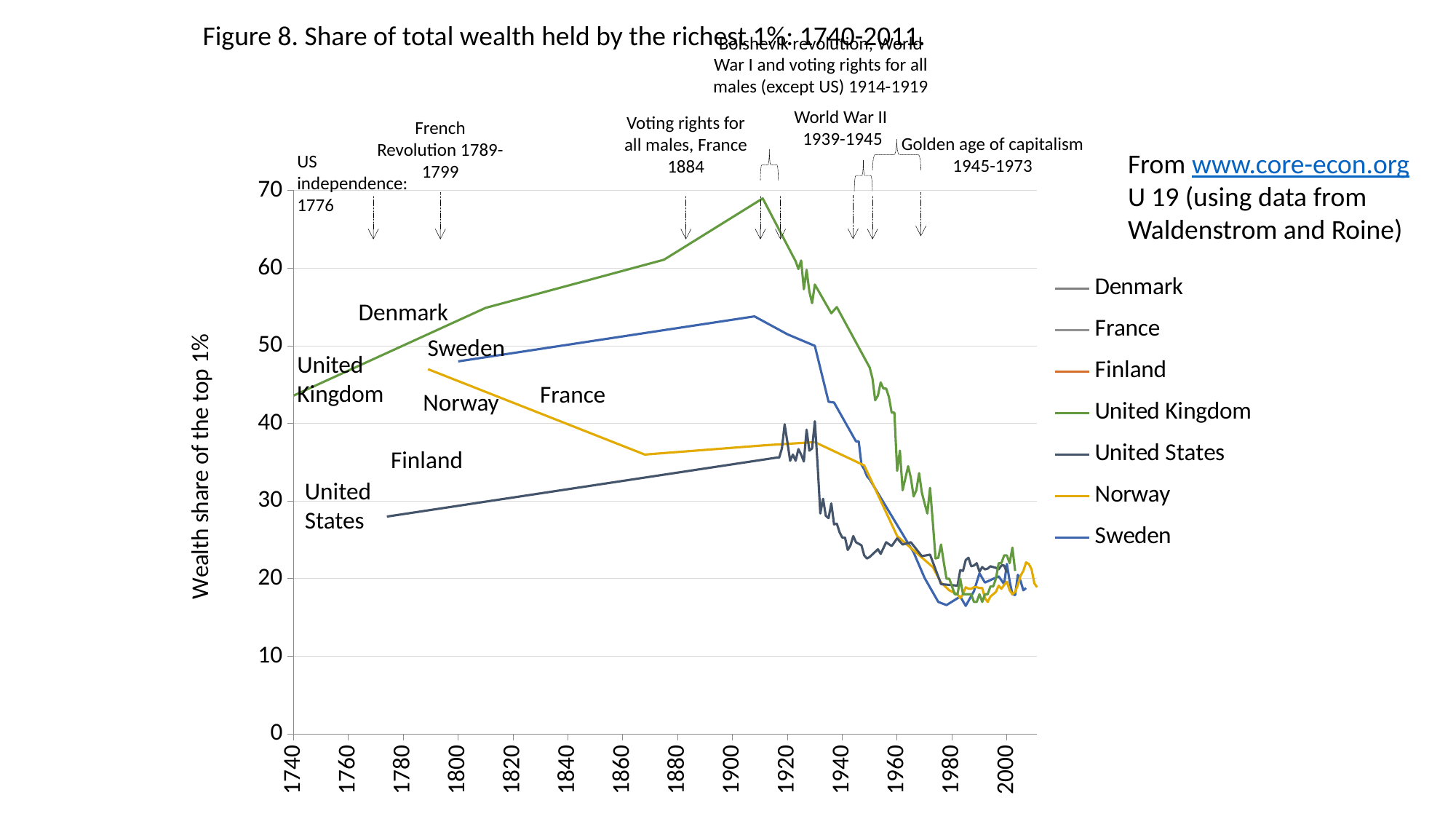
What is the title of the chart? Figure 8. Share of total wealth held by the richest 1%: 1740-2011 How many series does the legend list? 7 Which series has the highest value around 1910? United Kingdom What is the label on the vertical axis? Wealth share of the top 1% Is the value for Norway around 1790 greater or less than 40? greater Around 1900, which is larger: the value for the United Kingdom or the value for Sweden? United Kingdom Is the value for the United Kingdom around 1910 greater or less than 60? greater Is the value for Norway around 1870 greater or less than 40? less Around 1940, which is larger: the value for Sweden or the value for the United States? Sweden Does the United Kingdom line rise or fall between 1910 and 1980? fall What kind of chart is shown on the slide? line chart